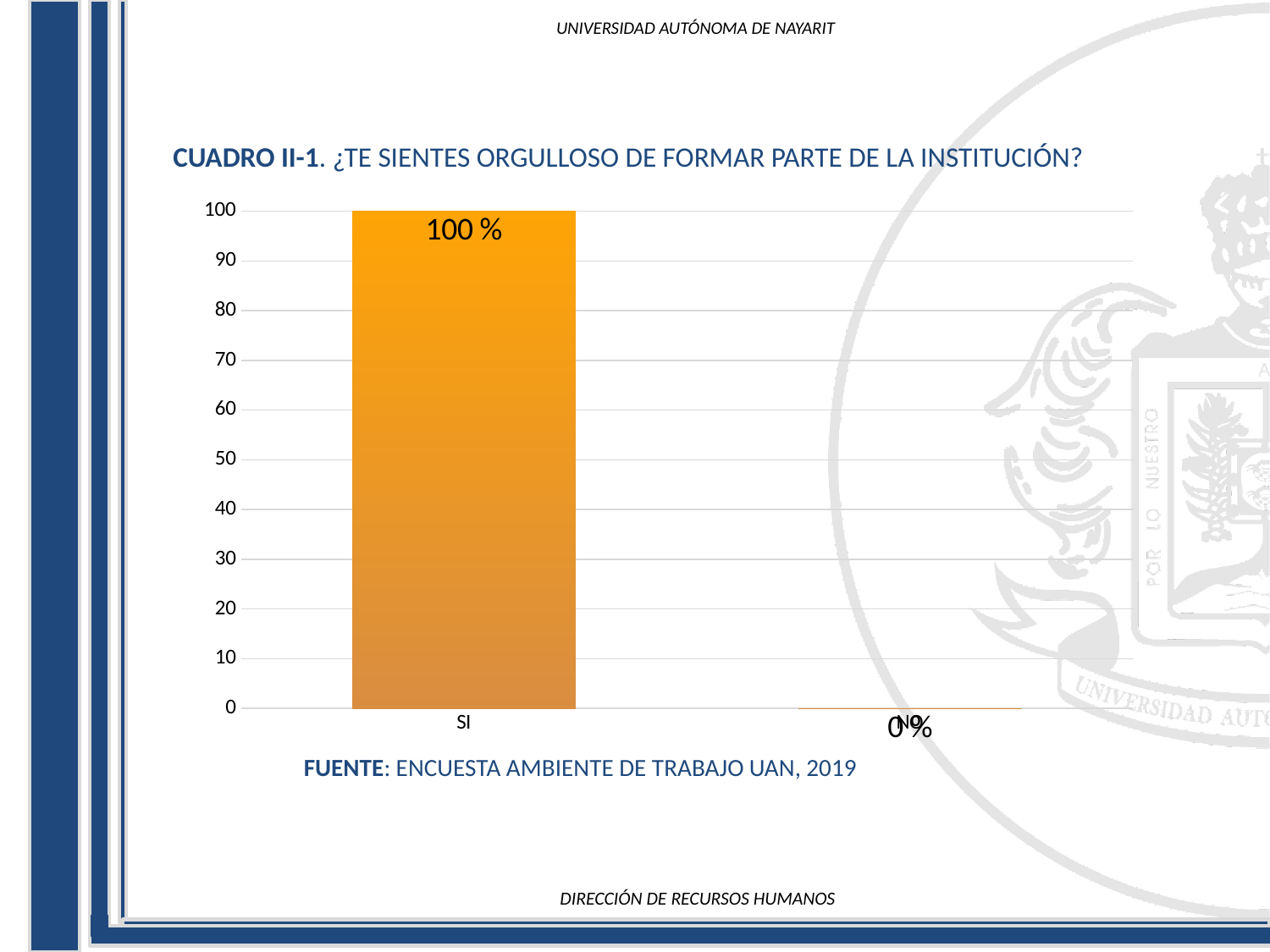
What is the difference between the value for SI and the value for NO? 100 What is the source cited below the chart? ENCUESTA AMBIENTE DE TRABAJO UAN, 2019 What value is shown for the NO category? 0% What kind of chart is shown on the slide? bar chart Which category has the highest value? SI Which category has the lowest value? NO How many categories are shown on the x axis? 2 Which is larger, the value for SI or the value for NO? SI What value is shown for the SI category? 100 % What is the maximum value shown on the vertical axis? 100 Is the value for SI greater or less than 50? greater